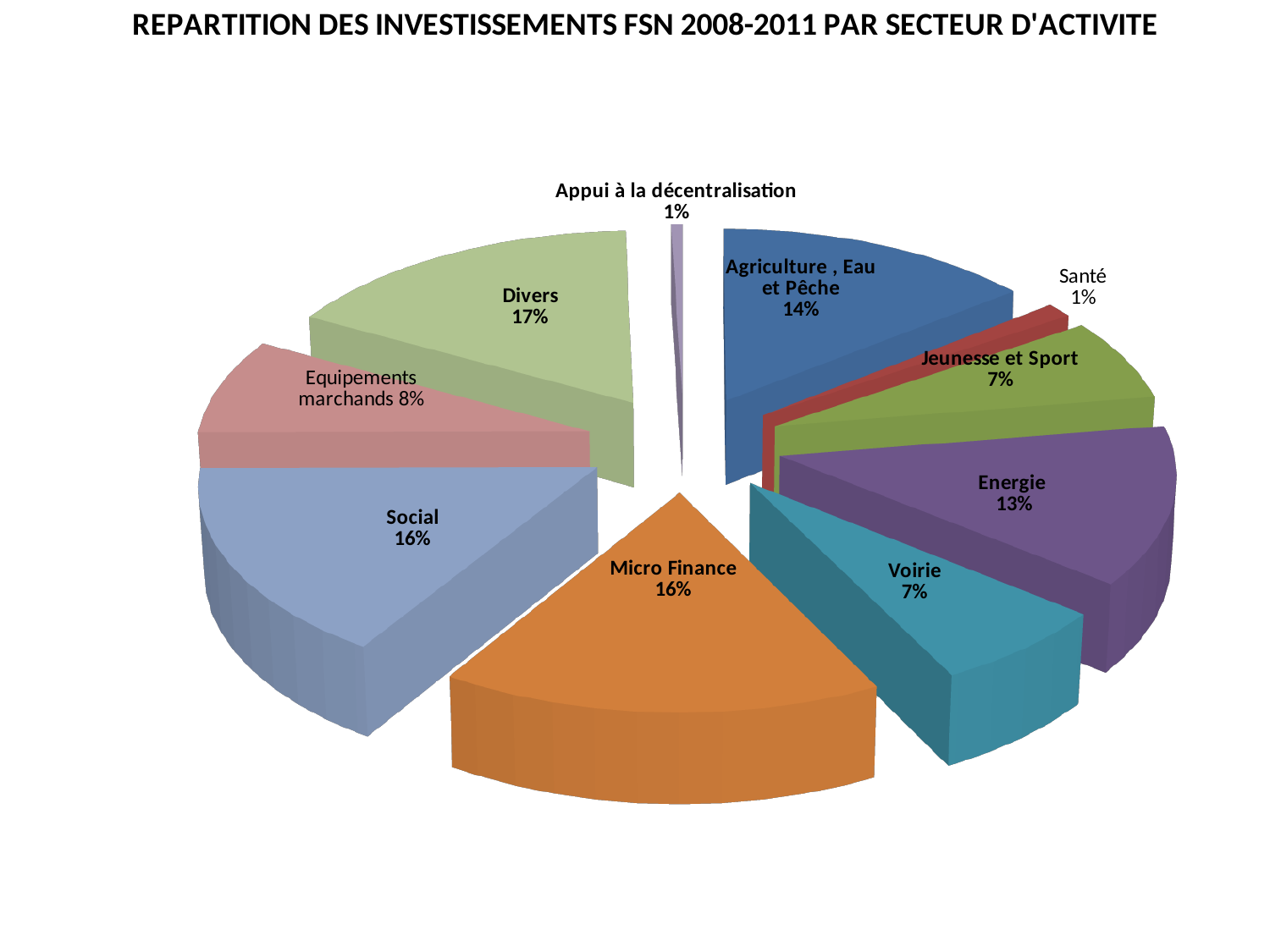
What share of the investments goes to Equipements marchands? 8% How many sectors (slices) does the pie chart show? 10 What share of the investments goes to Santé? 1% What share of the investments goes to Energie? 13% Which has a larger share, Energie or Jeunesse et Sport? Energie What is the difference in share between Divers and Micro Finance? 1% What kind of chart is shown on the slide? Pie chart What is the combined share of Social and Micro Finance? 32% Which sector has the largest share of the investments? Divers What is the title of the chart? REPARTITION DES INVESTISSEMENTS FSN 2008-2011 PAR SECTEUR D'ACTIVITE